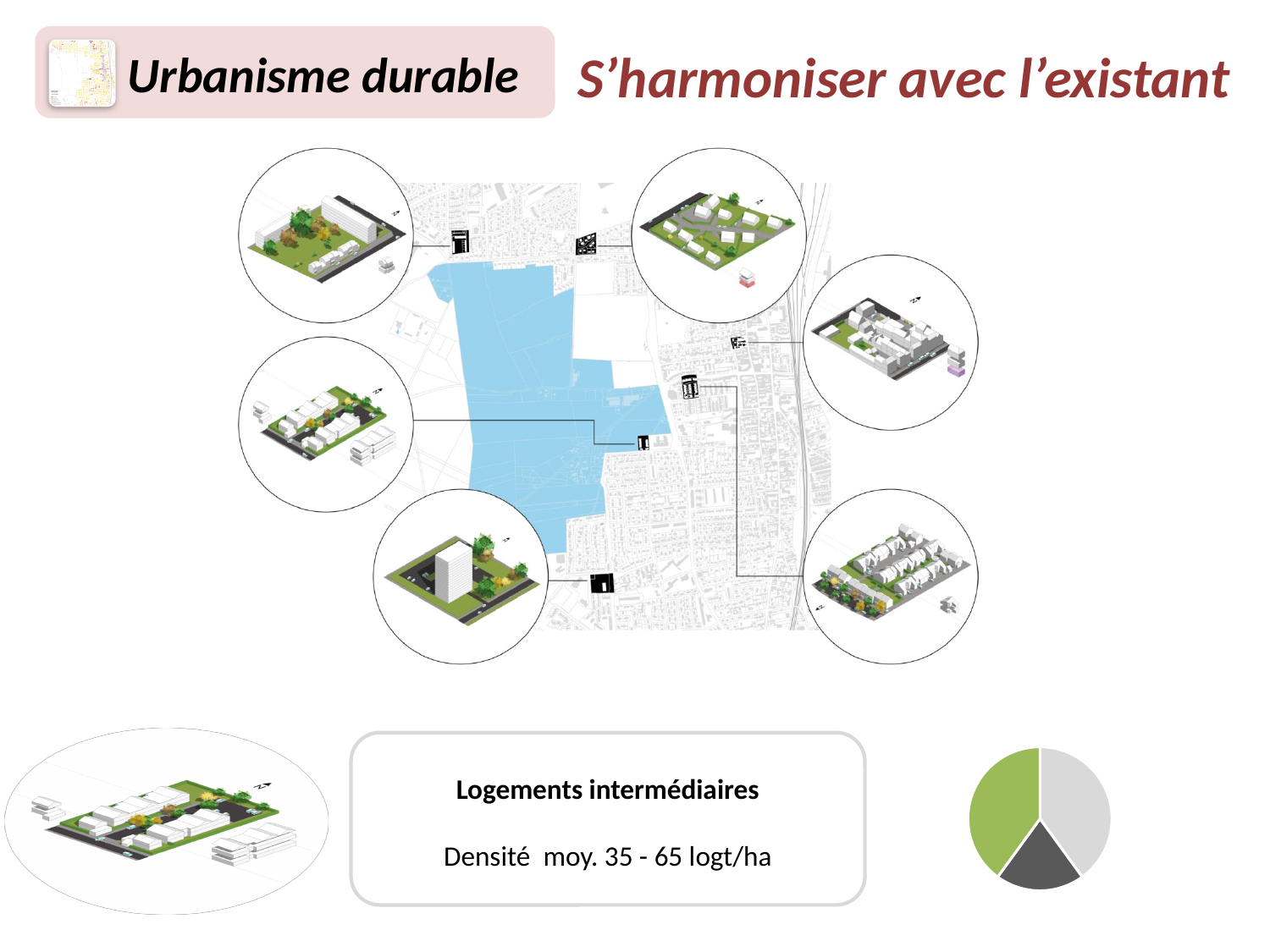
In the pie chart at the bottom right, which is larger, the light grey slice or the dark grey slice? the light grey slice In the pie chart at the bottom right, which slice is the smallest? the dark grey slice What kind of chart is shown at the bottom right of the slide? pie chart Does the pie chart at the bottom right of the slide show a legend or data labels? No In the pie chart at the bottom right, which is larger, the green slice or the dark grey slice? the green slice What colours are the slices of the pie chart at the bottom right of the slide? green, light grey and dark grey How many slices does the pie chart at the bottom right of the slide have? 3